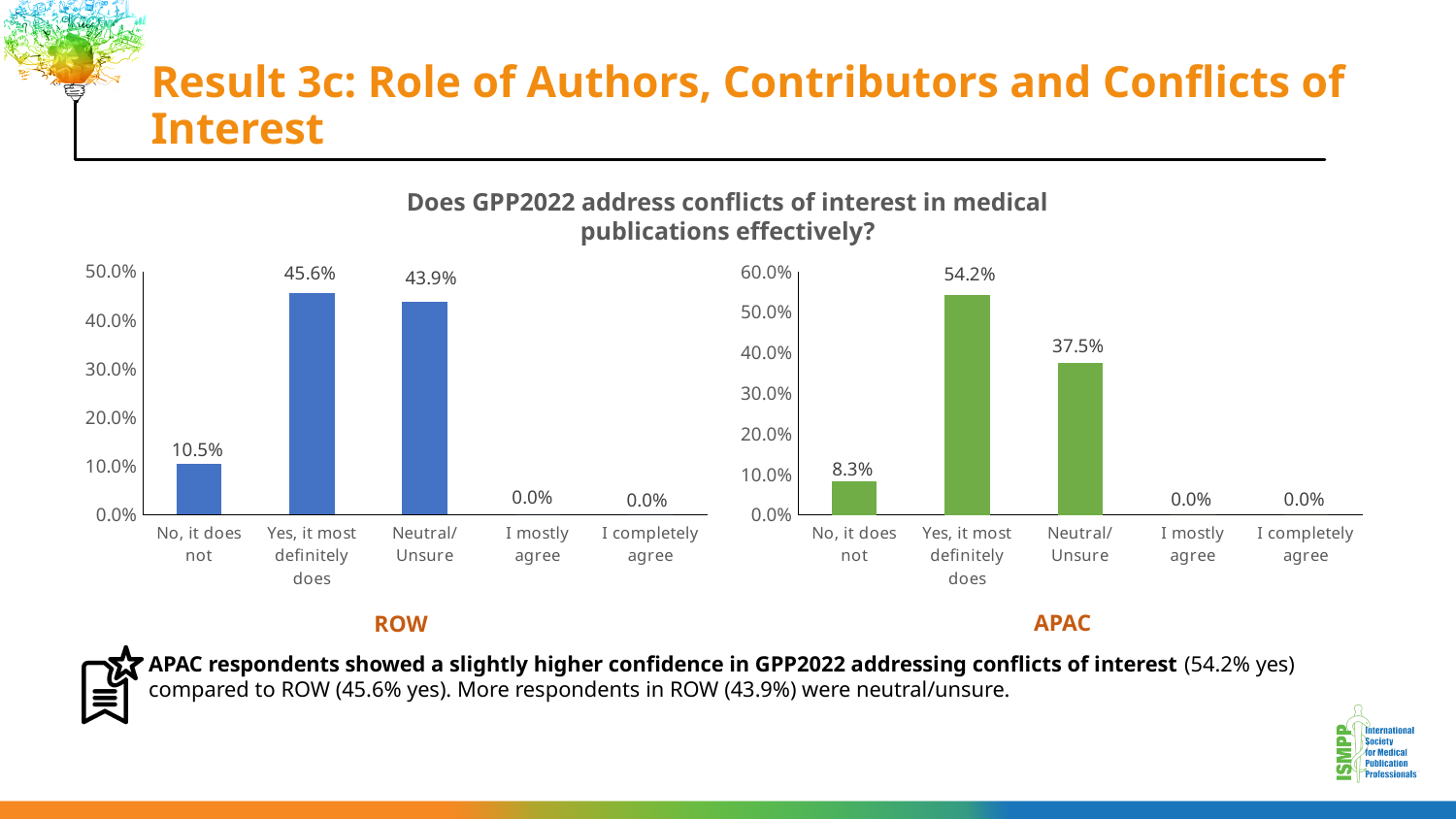
What is the shared title above the two charts? Does GPP2022 address conflicts of interest in medical publications effectively? In the ROW chart, what is the difference between "Yes, it most definitely does" and "Neutral/Unsure"? 1.7% In the APAC chart, what is the value for "Neutral/Unsure"? 37.5% In the ROW chart, which category has the highest value? Yes, it most definitely does In the ROW chart, what is the value for "Yes, it most definitely does"? 45.6% How many categories are shown on the x axis of the ROW chart? 5 Which chart shows a higher value for "Yes, it most definitely does", ROW or APAC? APAC Which chart shows a higher value for "No, it does not", ROW or APAC? ROW What type of chart is the APAC chart? Bar chart In the APAC chart, which category has the highest value? Yes, it most definitely does In the APAC chart, what is the difference between "Yes, it most definitely does" and "Neutral/Unsure"? 16.7% In the APAC chart, what is the value for "No, it does not"? 8.3%